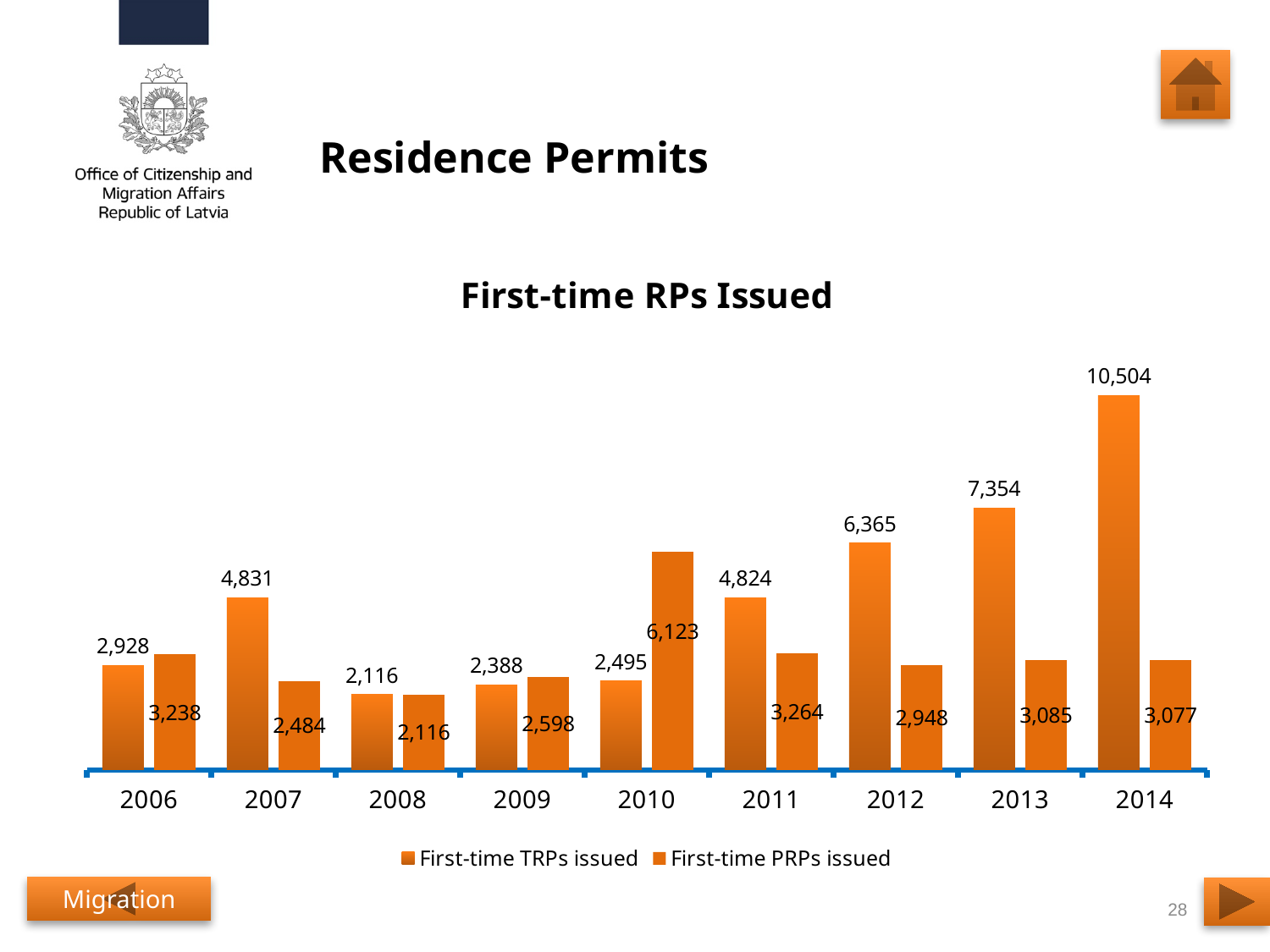
In which year were the most first-time TRPs issued? 2014 What is the value for first-time TRPs issued in 2007? 4,831 How many years are shown on the x axis? 9 Which was larger in 2006: first-time TRPs issued or first-time PRPs issued? First-time PRPs issued What is the difference between first-time TRPs issued in 2014 and in 2013? 3,150 Did first-time TRPs issued rise or fall from 2010 to 2014? Rise How many first-time PRPs were issued in 2010? 6,123 In which year were the most first-time PRPs issued? 2010 How many series does the legend list? 2 What kind of chart is shown on the slide? Bar chart How many first-time TRPs were issued in 2014? 10,504 In which year were the fewest first-time TRPs issued? 2008